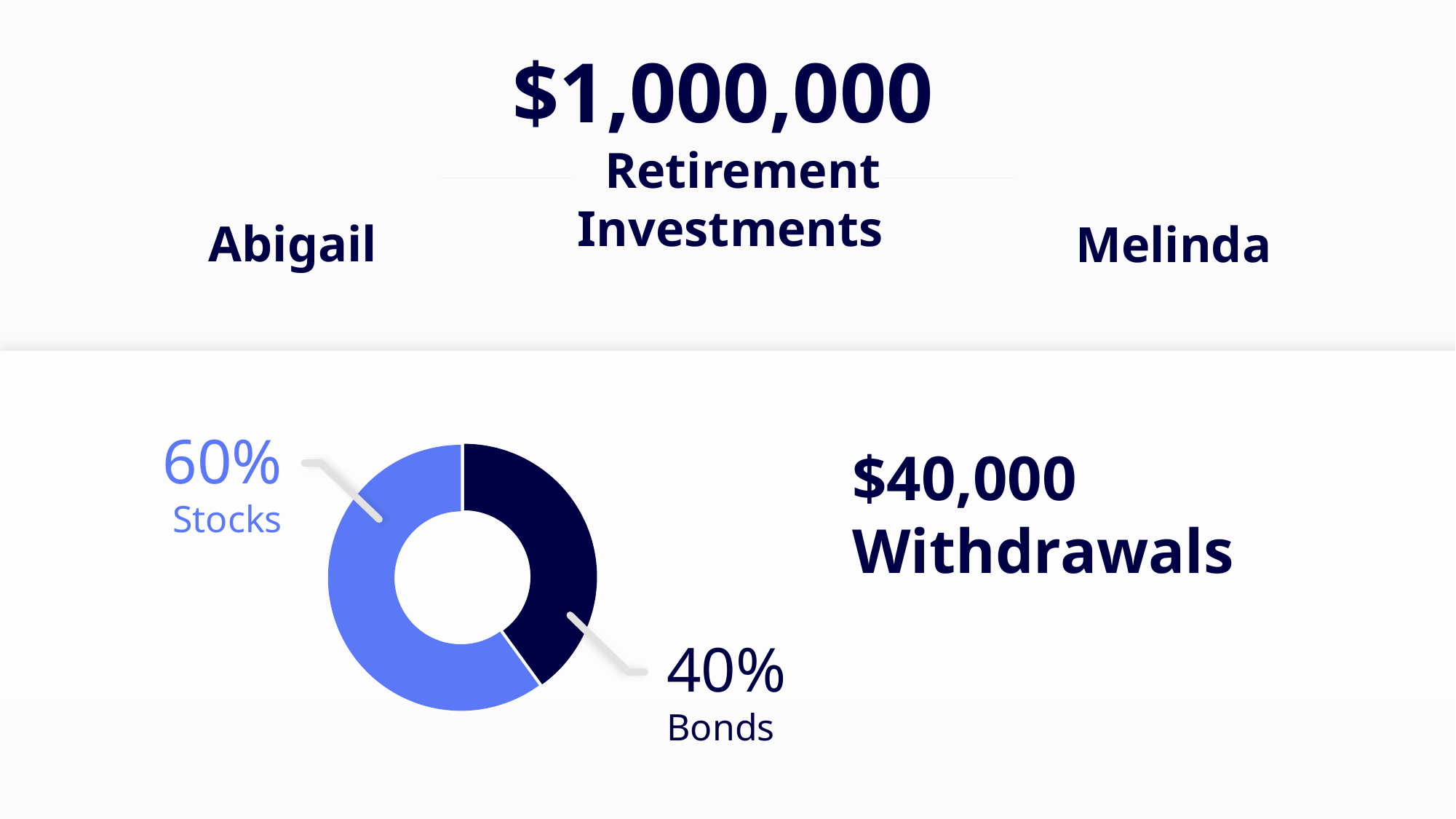
What do the two slices of the donut chart add up to? 100% What share of the donut chart is Stocks? 60% What is the difference in percentage points between the Stocks and Bonds slices? 20 percentage points What colour is the Bonds slice of the donut chart? Dark navy What kind of chart is shown on the slide? Donut (pie) chart Which slice of the donut chart is the largest? Stocks What share of the donut chart is Bonds? 40% Which slice of the donut chart is the smallest? Bonds How many slices does the donut chart have? 2 What colour is the Stocks slice of the donut chart? Light blue Which is larger in the donut chart, Stocks or Bonds? Stocks Is the Bonds share of the donut chart greater or less than 50%? less